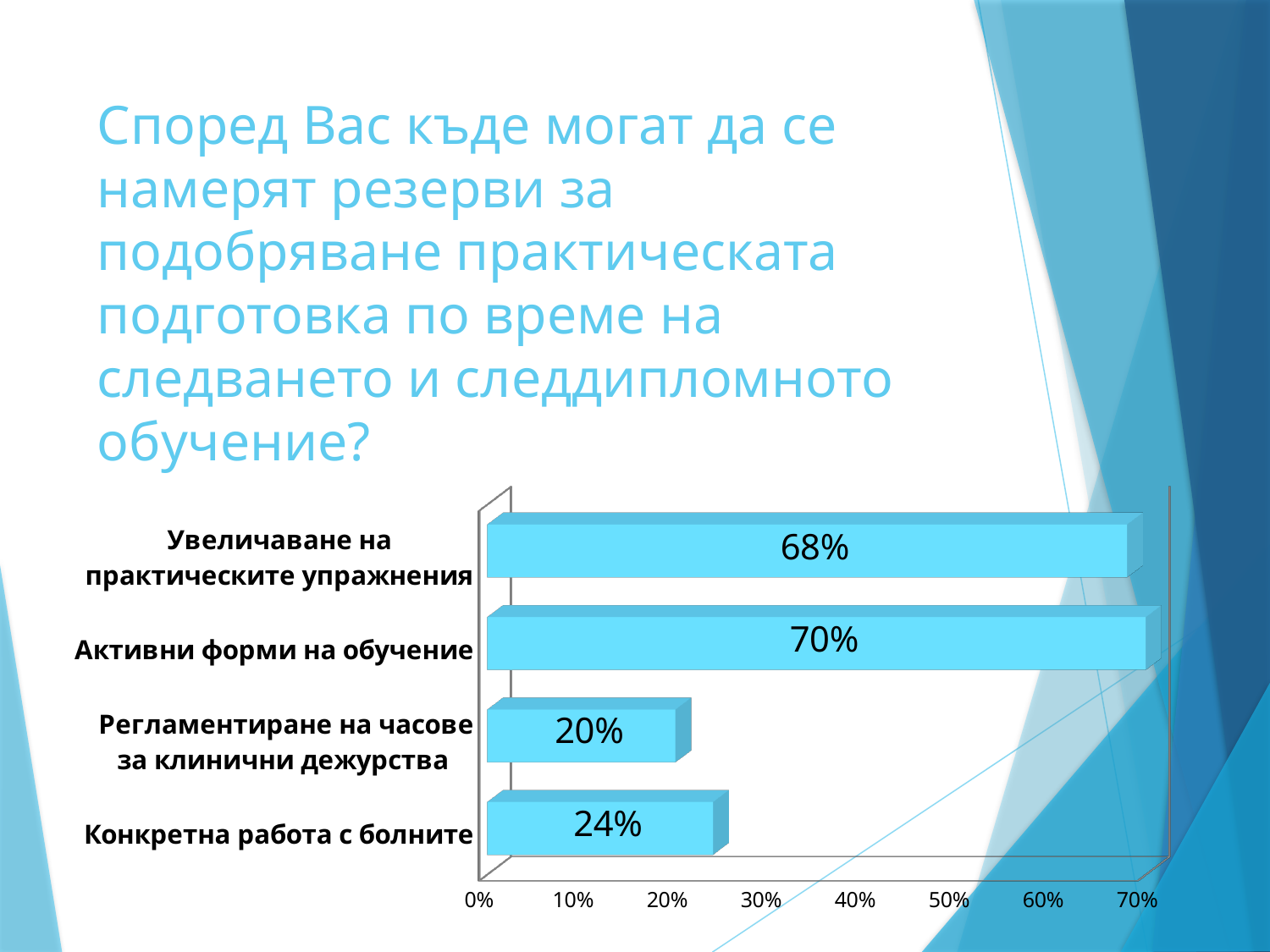
What value is shown for "Увеличаване на практическите упражнения"? 68% What value is shown for "Регламентиране на часове за клинични дежурства"? 20% Which category has the highest value? Активни форми на обучение Is the value for "Увеличаване на практическите упражнения" greater or less than 50%? greater What value is shown for "Конкретна работа с болните"? 24% What is the difference between the values for "Активни форми на обучение" and "Увеличаване на практическите упражнения"? 2% What is the difference between the values for "Конкретна работа с болните" and "Регламентиране на часове за клинични дежурства"? 4% What kind of chart is shown on the slide? bar chart How many categories are shown in the chart? 4 Which category has the lowest value? Регламентиране на часове за клинични дежурства Which is larger: the value for "Конкретна работа с болните" or for "Регламентиране на часове за клинични дежурства"? Конкретна работа с болните What value is shown for "Активни форми на обучение"? 70%